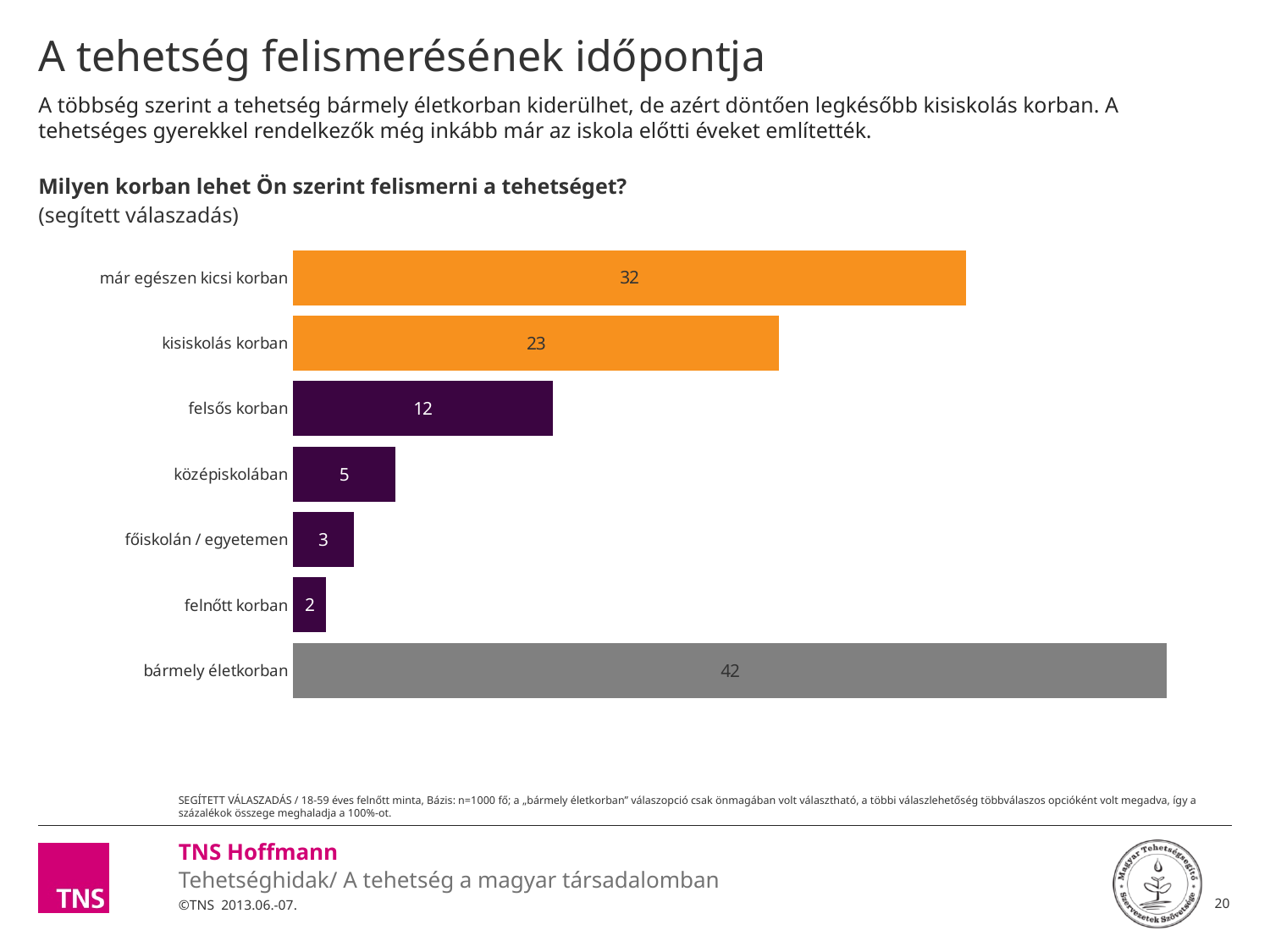
Which is larger, the value for "középiskolában" or the value for "főiskolán / egyetemen"? középiskolában What is the value for "bármely életkorban"? 42 What is the difference between the values for "bármely életkorban" and "felnőtt korban"? 40 What is the value for "felsős korban"? 12 Which category has the highest value? bármely életkorban How many categories are shown in the chart? 7 What kind of chart is shown on the slide? bar chart What is the value for "kisiskolás korban"? 23 Which category has the lowest value? felnőtt korban What colour is the bar for "bármely életkorban"? grey What is the difference between the values for "már egészen kicsi korban" and "kisiskolás korban"? 9 What is the value for "már egészen kicsi korban"? 32